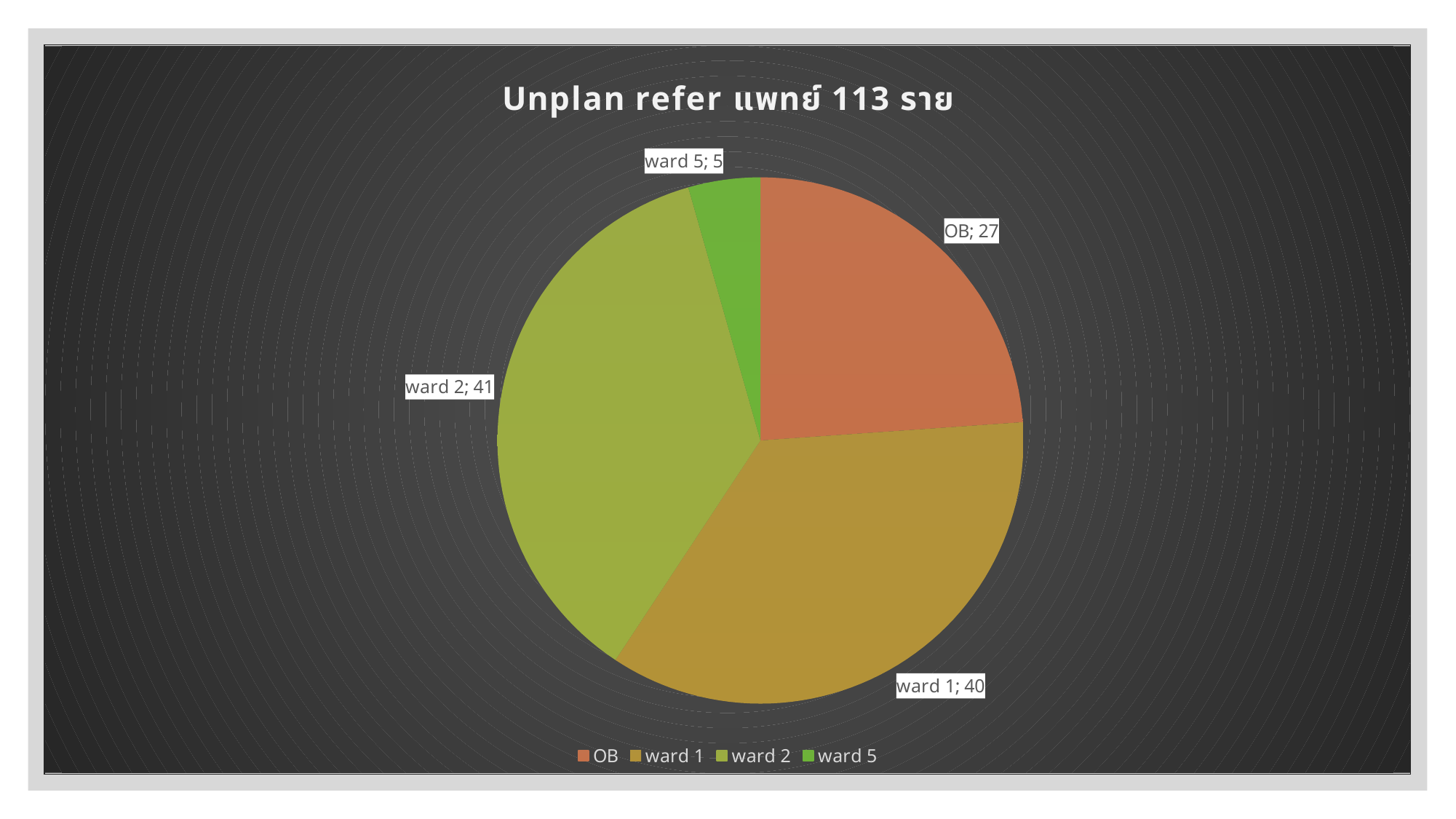
What is the value for ward 1 in the pie chart? 40 How many categories are shown in the pie chart? 4 What is the value for ward 5 in the pie chart? 5 What is the difference between the values for ward 1 and ward 5? 35 What is the value for ward 2 in the pie chart? 41 What is the title of the chart? Unplan refer แพทย์ 113 ราย Which category has the smallest slice in the pie chart? ward 5 Which is larger, the value for OB or the value for ward 1? ward 1 What is the difference between the values for ward 2 and OB? 14 What is the value for OB in the pie chart? 27 What kind of chart is shown on the slide? pie chart Which category has the largest slice in the pie chart? ward 2